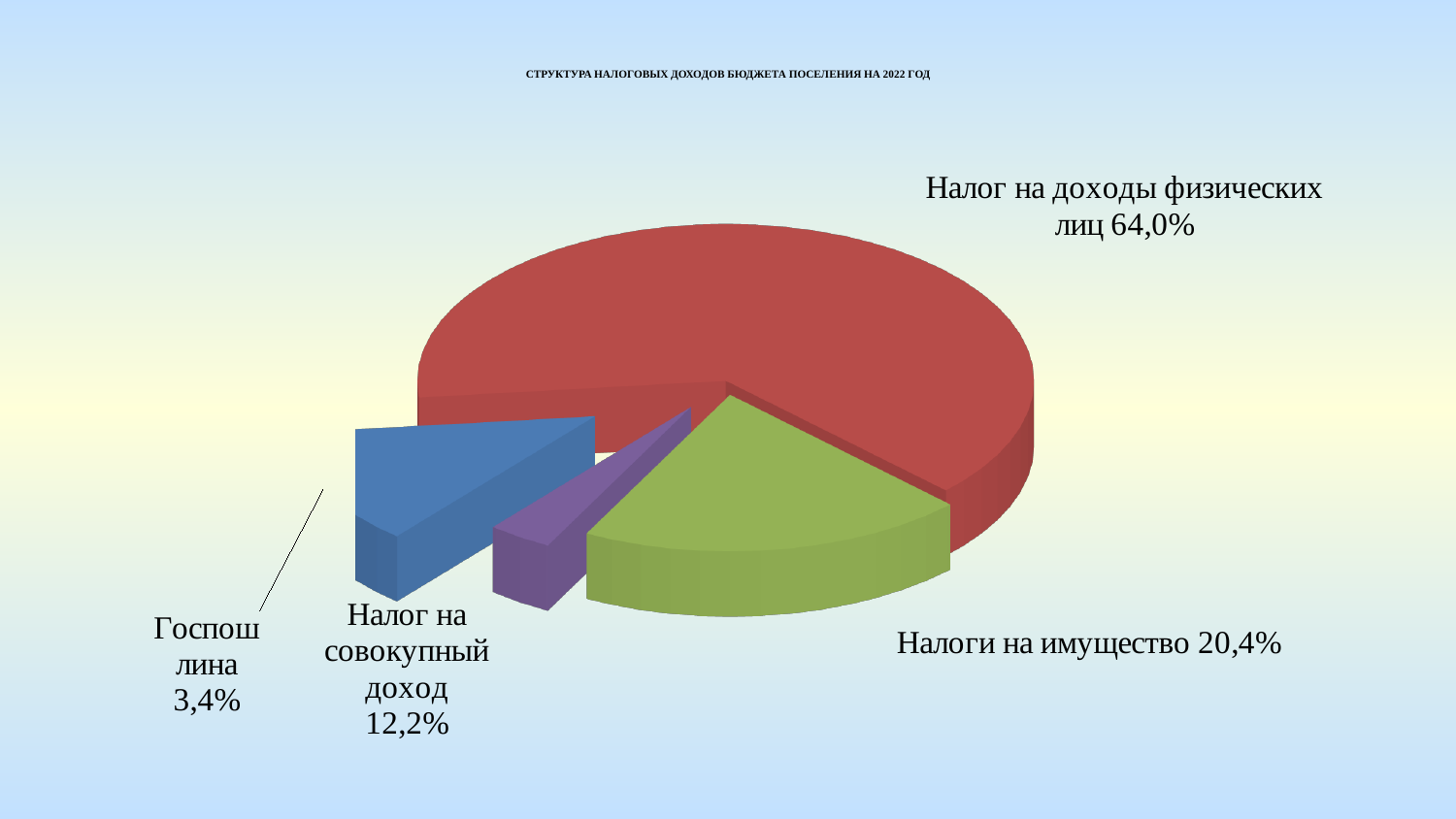
What kind of chart is shown on the slide? pie chart What is the title of the chart? СТРУКТУРА НАЛОГОВЫХ ДОХОДОВ БЮДЖЕТА ПОСЕЛЕНИЯ НА 2022 ГОД Which is larger: Налог на совокупный доход or Госпошлина? Налог на совокупный доход What share of the pie is Госпошлина? 3,4% How many slices does the pie chart have? 4 What is the difference in percentage points between Налог на доходы физических лиц and Налоги на имущество? 43,6 What share of the pie is Налог на совокупный доход? 12,2% What share of the pie is Налоги на имущество? 20,4% Which category has the largest share of the pie? Налог на доходы физических лиц Which category has the smallest share of the pie? Госпошлина What colour is the slice for Налог на доходы физических лиц? red